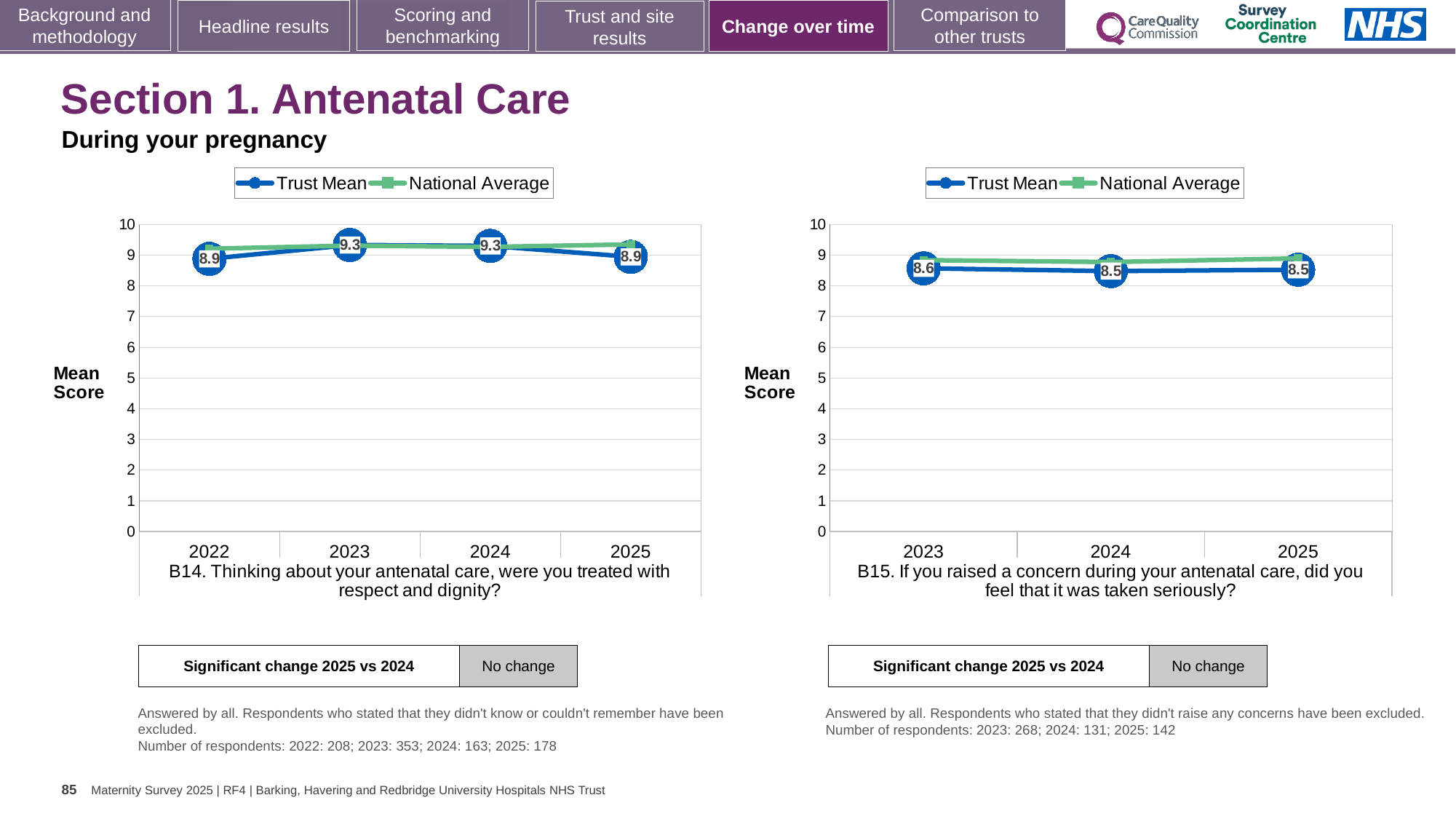
What kind of chart is the B14 chart on the left? line chart In the B15 chart on the right, does the Trust Mean rise or fall from 2023 to 2025? fall How many years are shown on the x axis of the B15 chart on the right? 3 In the B14 chart on the left, is the National Average for 2022 greater or less than 8? greater In the B14 chart on the left, what is the Trust Mean for 2025? 8.9 In the B14 chart on the left, what is the Trust Mean for 2023? 9.3 In the B15 chart on the right, is the Trust Mean for 2023 larger or smaller than the Trust Mean for 2024? larger In the B14 chart on the left, which year has the lowest Trust Mean, 2022 or 2023? 2022 In the B15 chart on the right, what is the Trust Mean for 2025? 8.5 In the B15 chart on the right, what is the Trust Mean for 2023? 8.6 In the B14 chart on the left, what is the difference between the Trust Mean for 2023 and the Trust Mean for 2022? 0.4 How many series does the legend of the B14 chart on the left list? 2